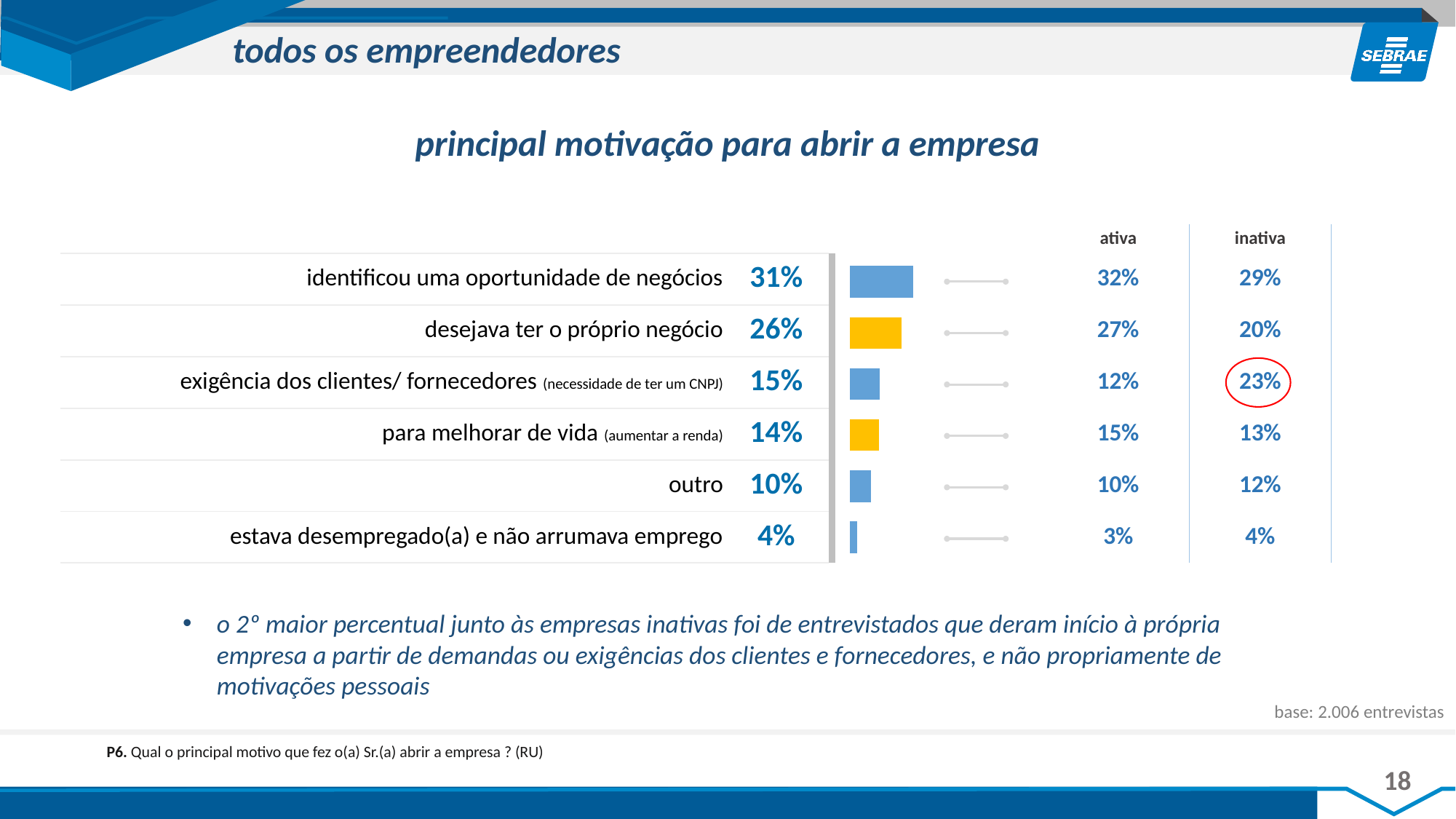
How many motivation categories are shown in the chart? 6 What percentage of entrepreneurs cited 'identificou uma oportunidade de negócios' as their main motivation? 31% What is the 'inativa' value for 'exigência dos clientes/ fornecedores'? 23% What is the 'ativa' value for 'para melhorar de vida'? 15% What is the title of the chart? principal motivação para abrir a empresa What kind of chart is used to display the overall percentages? bar chart What is the difference between the overall values for 'identificou uma oportunidade de negócios' and 'desejava ter o próprio negócio'? 5 percentage points Which motivation has the highest overall percentage? identificou uma oportunidade de negócios Which motivation has the lowest overall percentage? estava desempregado(a) e não arrumava emprego What is the difference between the 'ativa' and 'inativa' values for 'desejava ter o próprio negócio'? 7 percentage points For 'exigência dos clientes/ fornecedores', which is larger: the 'ativa' value or the 'inativa' value? inativa What is the overall value for 'desejava ter o próprio negócio'? 26%